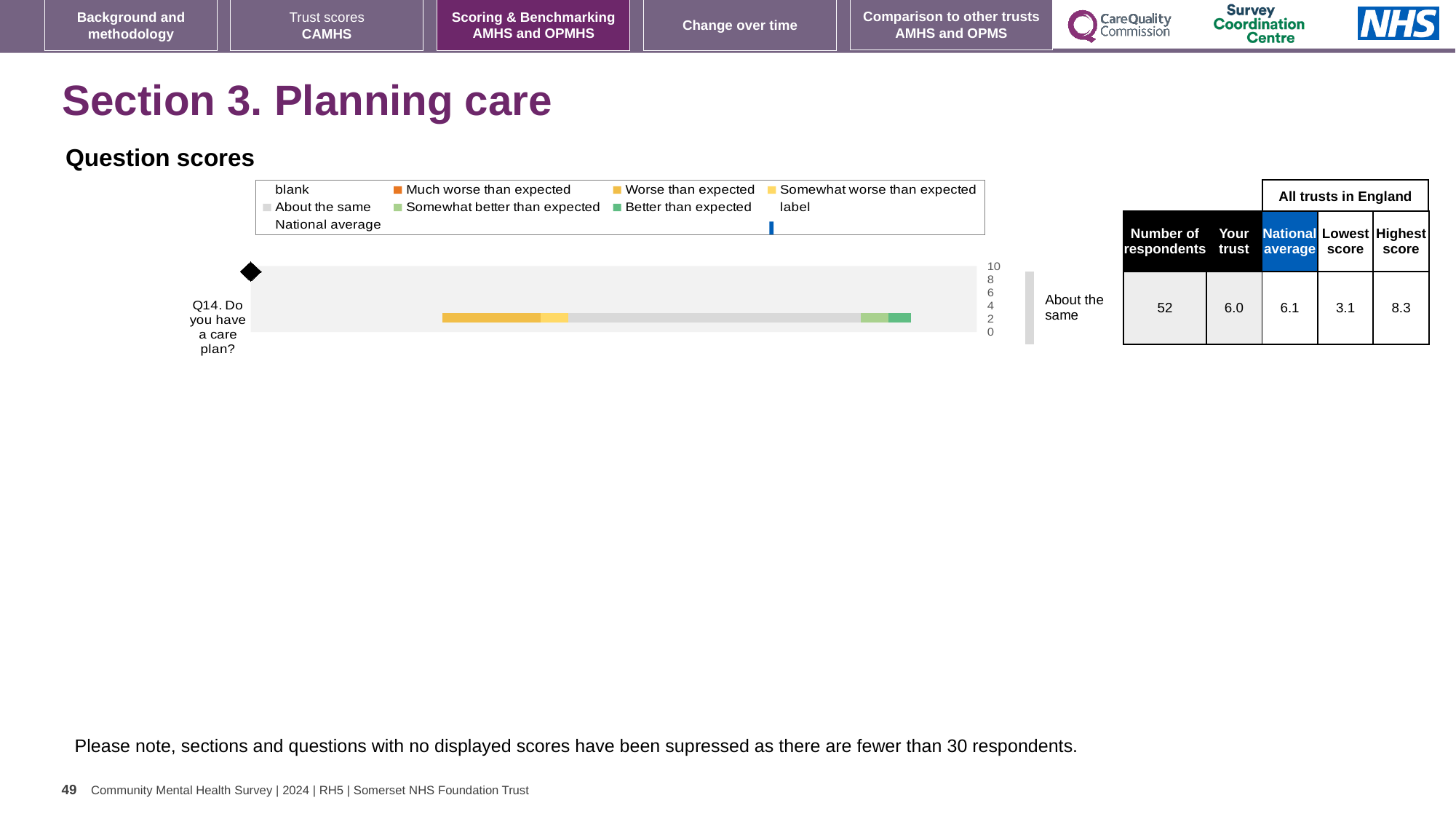
What is the Highest score among all trusts in England for Q14? 8.3 What is the National average score for Q14? 6.1 What is the 'Your trust' score for Q14 in the table beside the chart? 6.0 What is the Lowest score among all trusts in England for Q14? 3.1 Which question is plotted in the Question scores chart? Q14. Do you have a care plan? What is the difference between the Highest score and the Lowest score for Q14? 5.2 What kind of chart is used to show the Q14 question score? bar chart How many questions are plotted in the Question scores chart? 1 What benchmark rating is shown next to the bar for Q14? About the same How many respondents answered Q14? 52 By how much does the National average exceed the 'Your trust' score for Q14? 0.1 For Q14, which is larger: the 'Your trust' score or the National average? National average